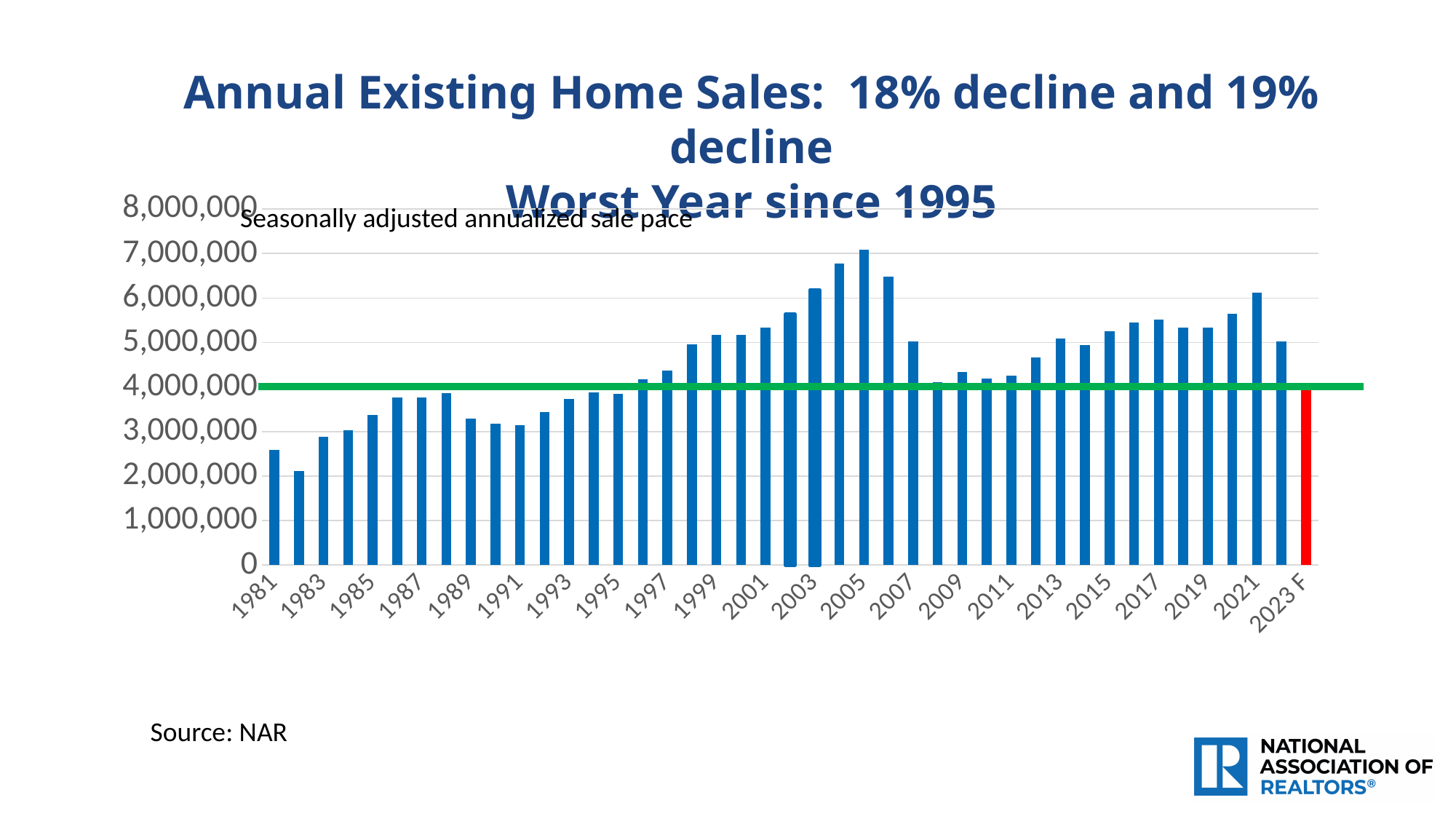
What colour is the bar for 2023 F? Red Is the value for 1982 greater or less than 3,000,000? less What kind of chart is shown on the slide? Bar chart Do the values rise or fall from 2005 to 2008? fall Is the value for 2023 F greater or less than 5,000,000? less Which year has the larger value, 2005 or 2021? 2005 Which year has the lowest annual existing home sales? 1982 Is the value for 2005 greater or less than 6,000,000? greater Which year has the highest annual existing home sales? 2005 What is the source cited for the chart? NAR Which year has the larger value, 1981 or 1982? 1981